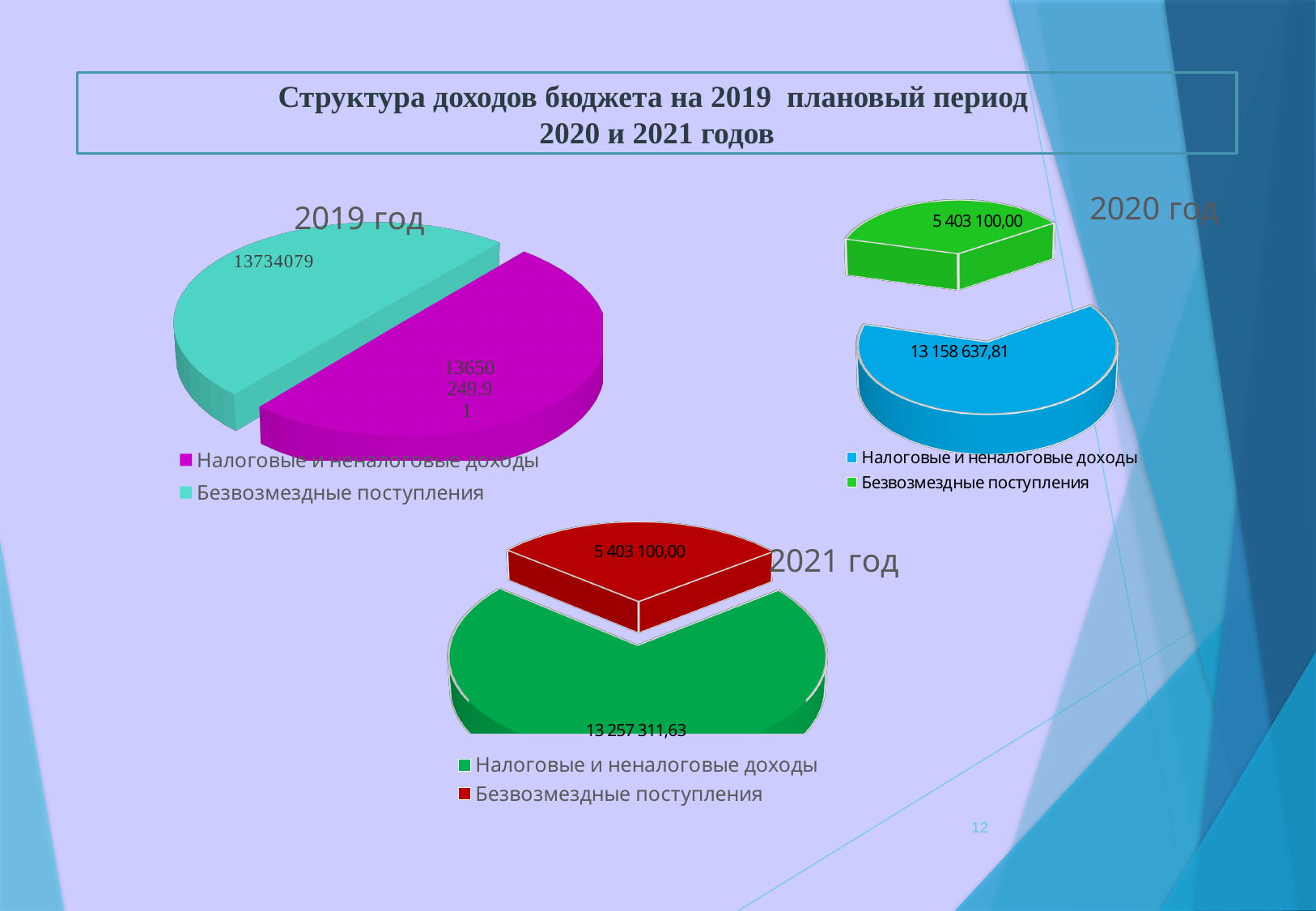
In the 2020 год pie chart, what is the value for Налоговые и неналоговые доходы? 13 158 637,81 In the 2020 год pie chart, what is the difference between Налоговые и неналоговые доходы and Безвозмездные поступления? 7 755 537,81 In the 2021 год pie chart, what is the value for Безвозмездные поступления? 5 403 100,00 What type of chart is used for 2021 год? Pie chart In the 2021 год pie chart, which category has the smallest value? Безвозмездные поступления In the 2020 год pie chart, what is the value for Безвозмездные поступления? 5 403 100,00 How many categories does the legend of the 2019 год chart list? 2 In the 2019 год pie chart, what is the value for Безвозмездные поступления? 13734079 In the 2020 год pie chart, which category has the largest value? Налоговые и неналоговые доходы In the 2021 год pie chart, what is the total of the two slices? 18 660 411,63 In the 2021 год pie chart, which is larger: Налоговые и неналоговые доходы or Безвозмездные поступления? Налоговые и неналоговые доходы In the 2021 год pie chart, what is the value for Налоговые и неналоговые доходы? 13 257 311,63